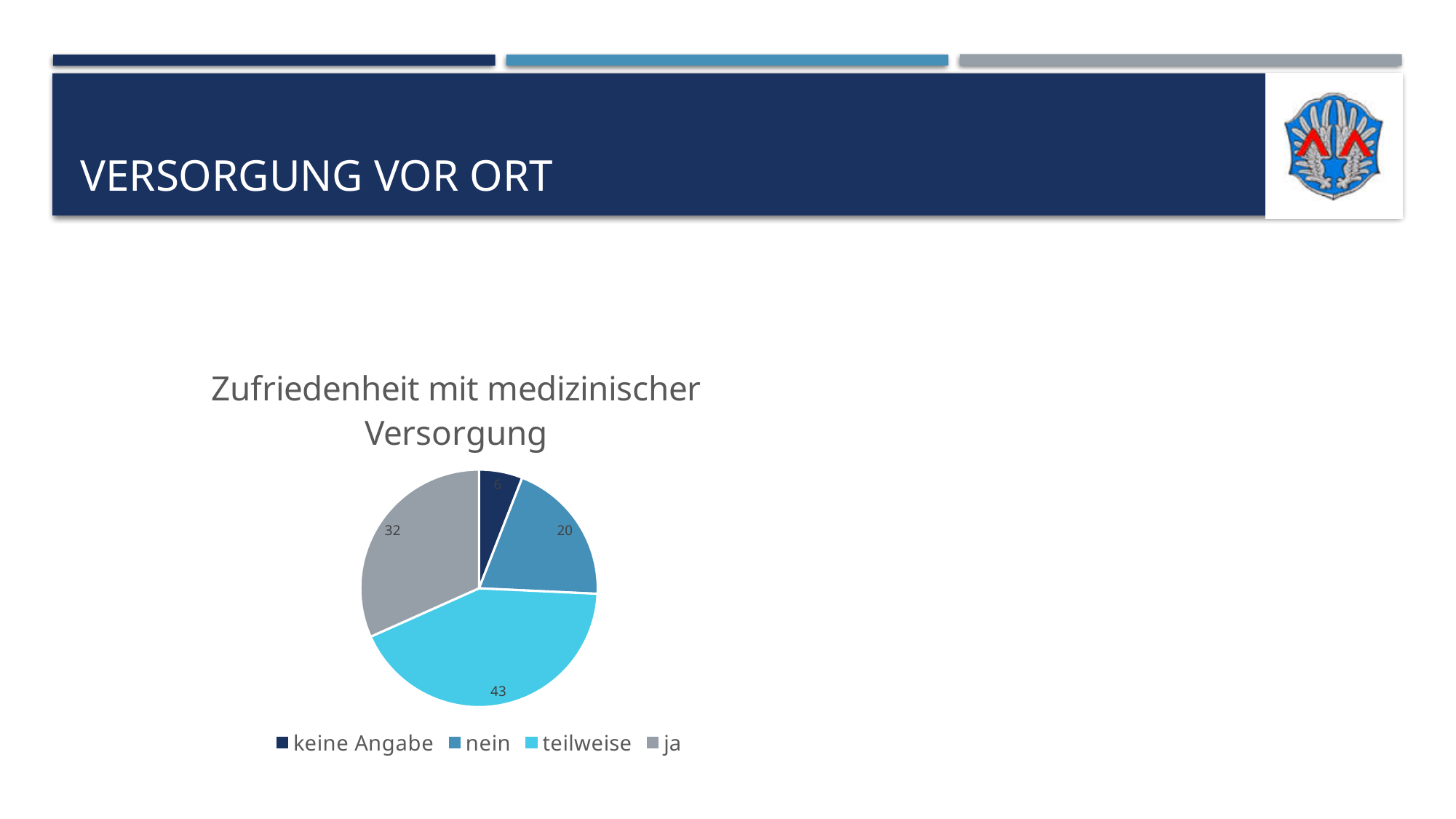
What is the value for "keine Angabe"? 6 Which is larger, the value for "nein" or the value for "ja"? ja Which category has the largest slice? teilweise What is the total of all slices in the pie chart? 101 What kind of chart is shown on the slide? pie chart What is the value for "ja"? 32 How many categories does the legend list? 4 What is the value for "teilweise"? 43 What is the value for "nein"? 20 Which category has the smallest slice? keine Angabe What is the difference between the values for "teilweise" and "ja"? 11 What is the title of the chart? Zufriedenheit mit medizinischer Versorgung